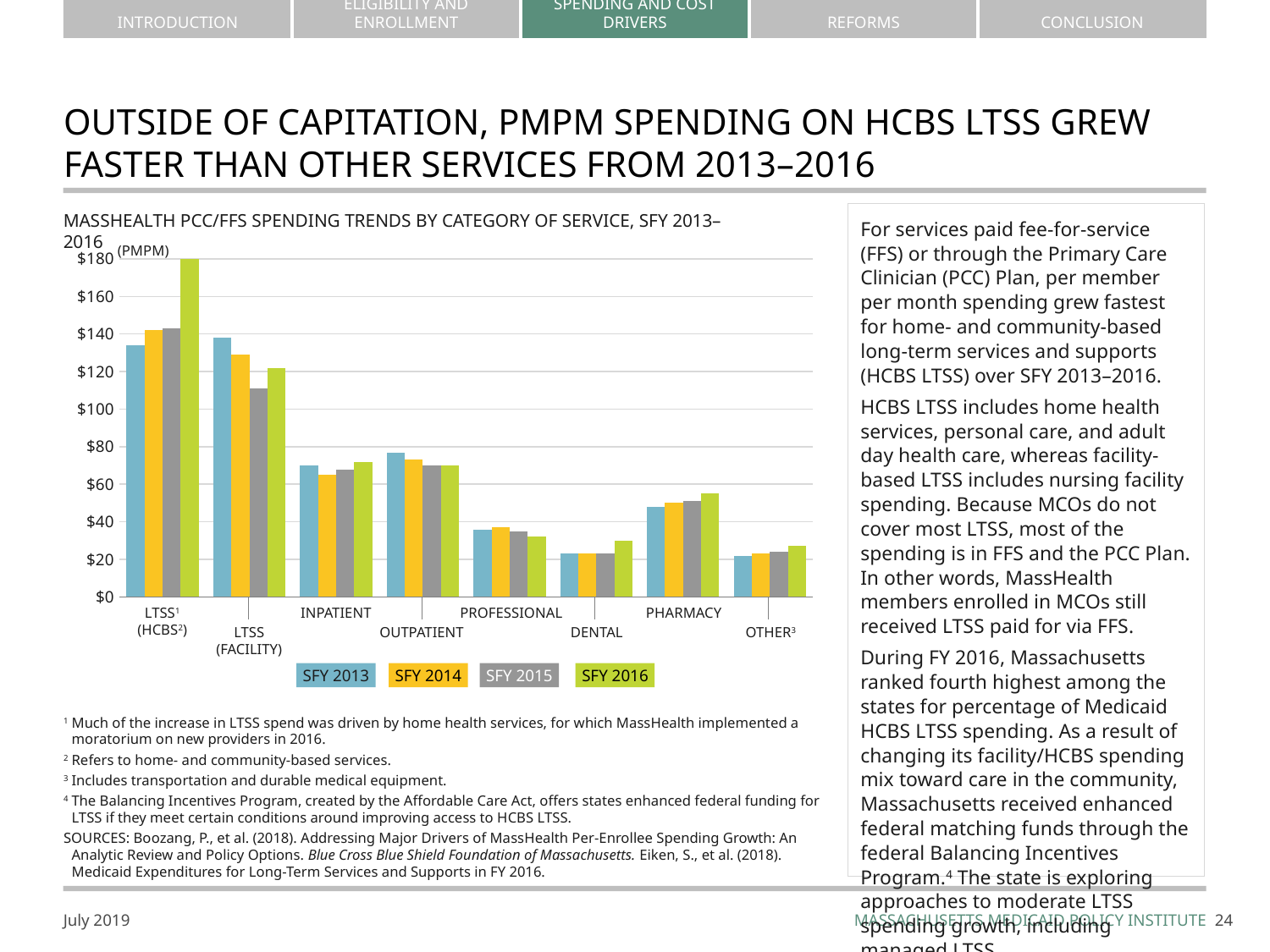
Is the SFY 2016 value for PHARMACY greater or less than $40? greater Which is larger, the SFY 2016 value for PHARMACY or the SFY 2016 value for DENTAL? PHARMACY Which category of service has the highest SFY 2016 bar? LTSS (HCBS) Do the LTSS (FACILITY) bars rise or fall from SFY 2013 to SFY 2015? fall Is the SFY 2016 value for LTSS (HCBS) greater or less than $160? greater Is the SFY 2013 value for OUTPATIENT greater or less than $60? greater Do the LTSS (HCBS) bars rise or fall from SFY 2013 to SFY 2016? rise Which colour represents SFY 2016 in the legend? Green How many categories of service are shown on the x axis? 8 What kind of chart is shown on the slide? Bar chart How many series does the legend list? 4